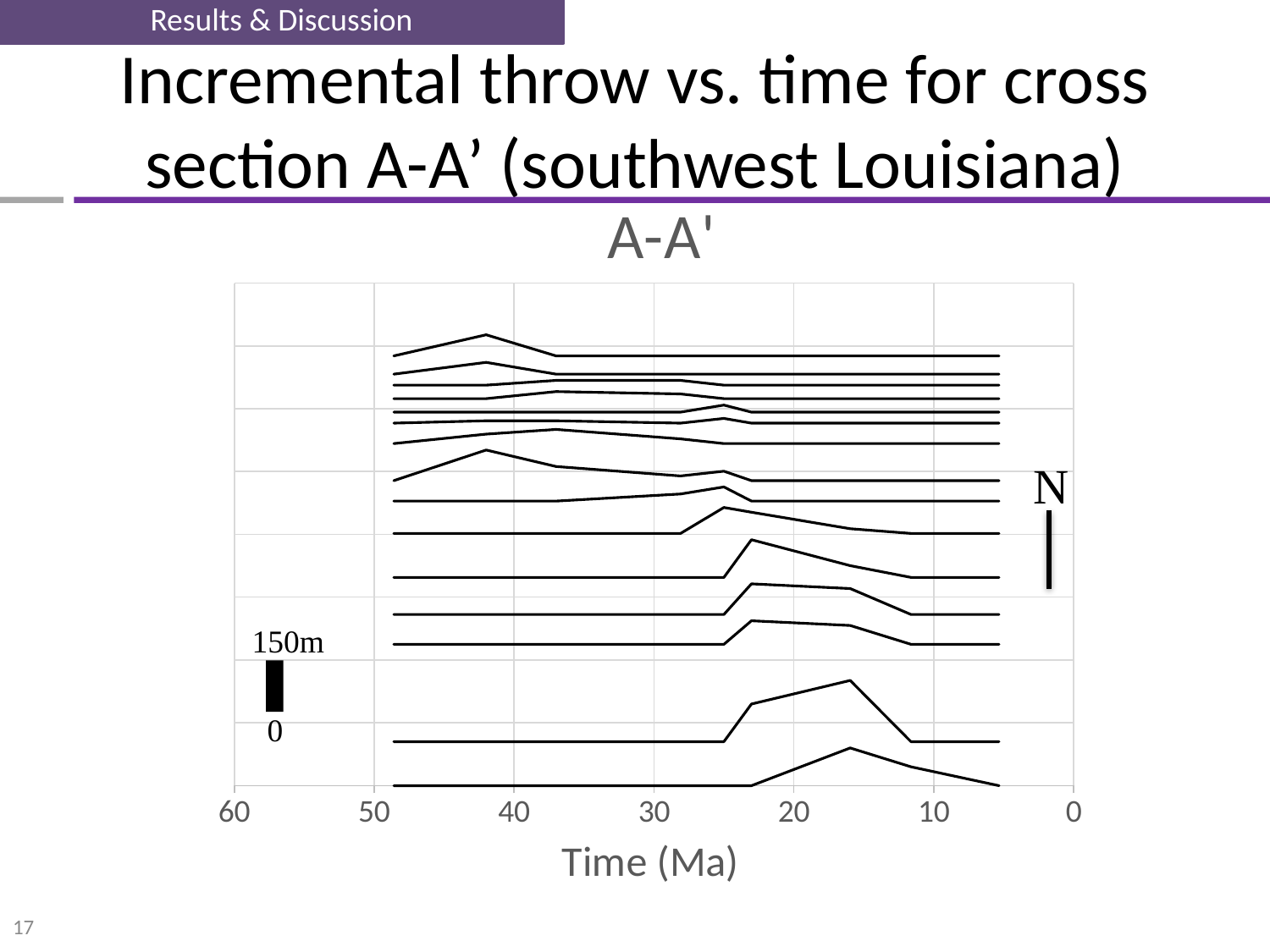
Do the x-axis values increase or decrease from left to right? decrease Does the chart display a legend? No What is the title of the chart? A-A' Between which two x-axis tick values does the top-most line reach its peak? 50 and 40 What is the label of the x axis? Time (Ma) What length does the vertical scale bar on the chart represent? 150m What is the rightmost value shown on the x axis? 0 What is the leftmost value shown on the x axis? 60 How many tick labels are shown on the x axis? 7 Between which two x-axis tick values does the bottom-most line reach its peak? 20 and 10 What kind of chart is shown on the slide? line chart